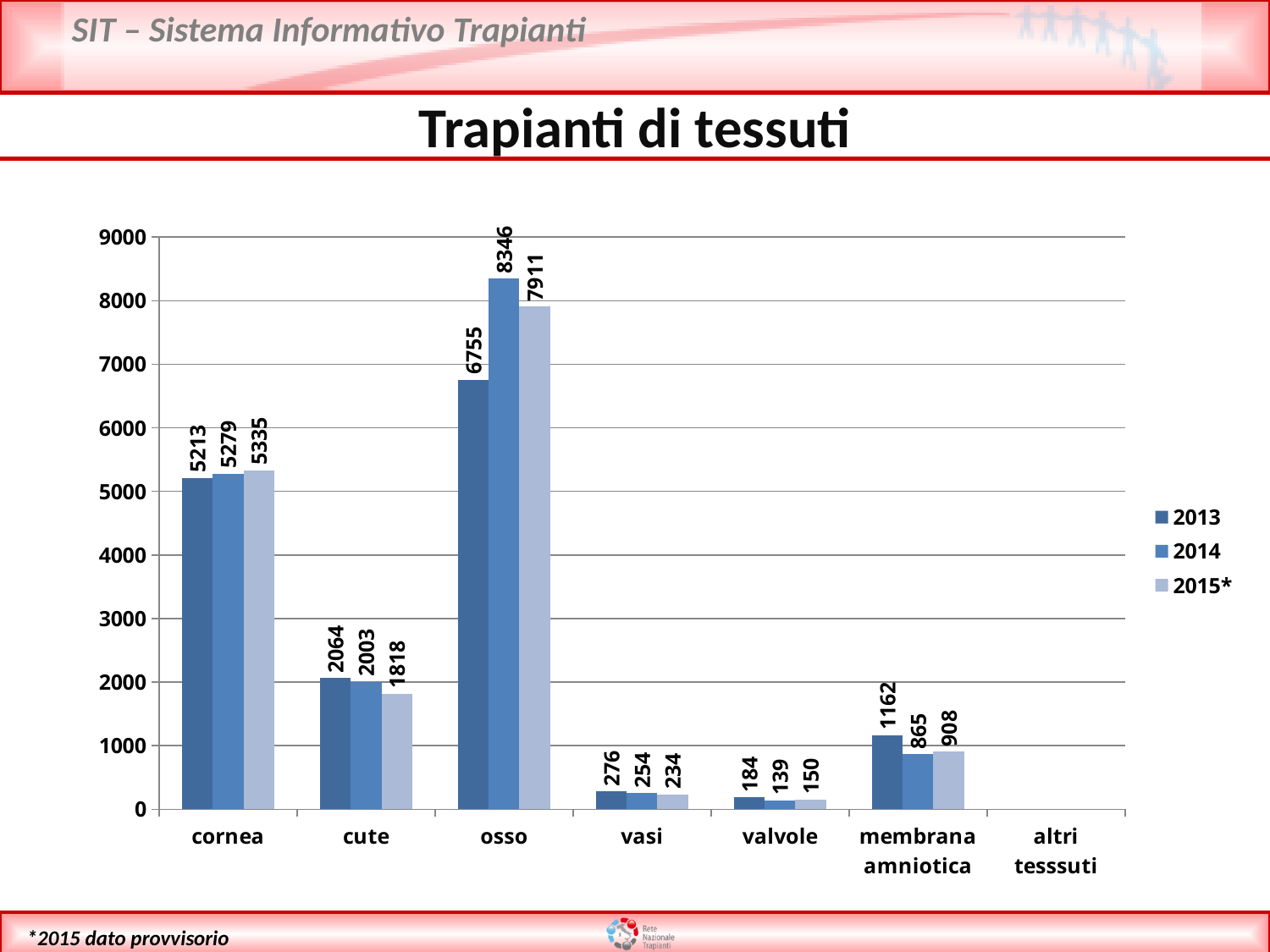
Which is larger: the 2013 value for cute or the 2015* value for cute? 2013 value for cute How many categories are shown on the x axis? 7 What is the difference between the 2014 and 2015* values for osso? 435 What kind of chart is shown on the slide? bar chart What is the value for osso in 2014? 8346 What is the difference between the 2013 and 2014 values for membrana amniotica? 297 How many series does the legend list? 3 Among the categories with labelled values, which has the lowest value in 2014? valvole Do the values for cornea rise or fall from 2013 to 2015*? rise What is the value for membrana amniotica in 2015*? 908 Which category has the highest value in 2015*? osso What is the value for cornea in 2013? 5213